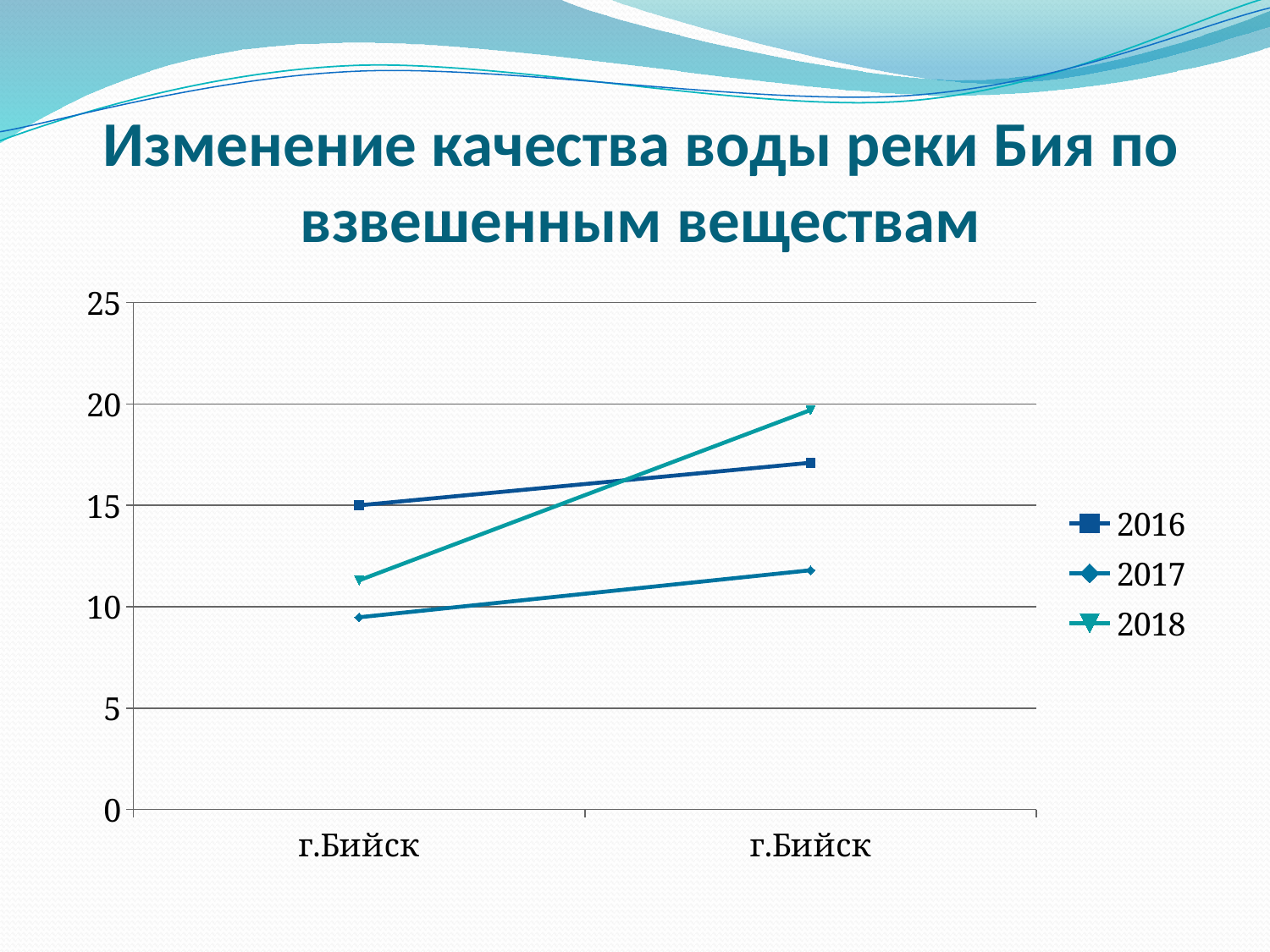
Which series has the lowest value at the left point? 2017 Is the value of the 2016 series at the right point greater or less than 20? less Does the 2018 line rise or fall from the left point to the right point? rises How many points are plotted along the x axis for each series? 2 At the right point, which series has the larger value, 2016 or 2018? 2018 Is the value of the 2018 series at the right point greater or less than 15? greater What is the title of the chart on the slide? Изменение качества воды реки Бия по взвешенным веществам At the left point, which series has the larger value, 2016 or 2018? 2016 Does the 2017 line rise or fall from the left point to the right point? rises Is the value of the 2017 series at the left point greater or less than 10? less What kind of chart is shown on the slide? line chart How many series does the legend list? 3